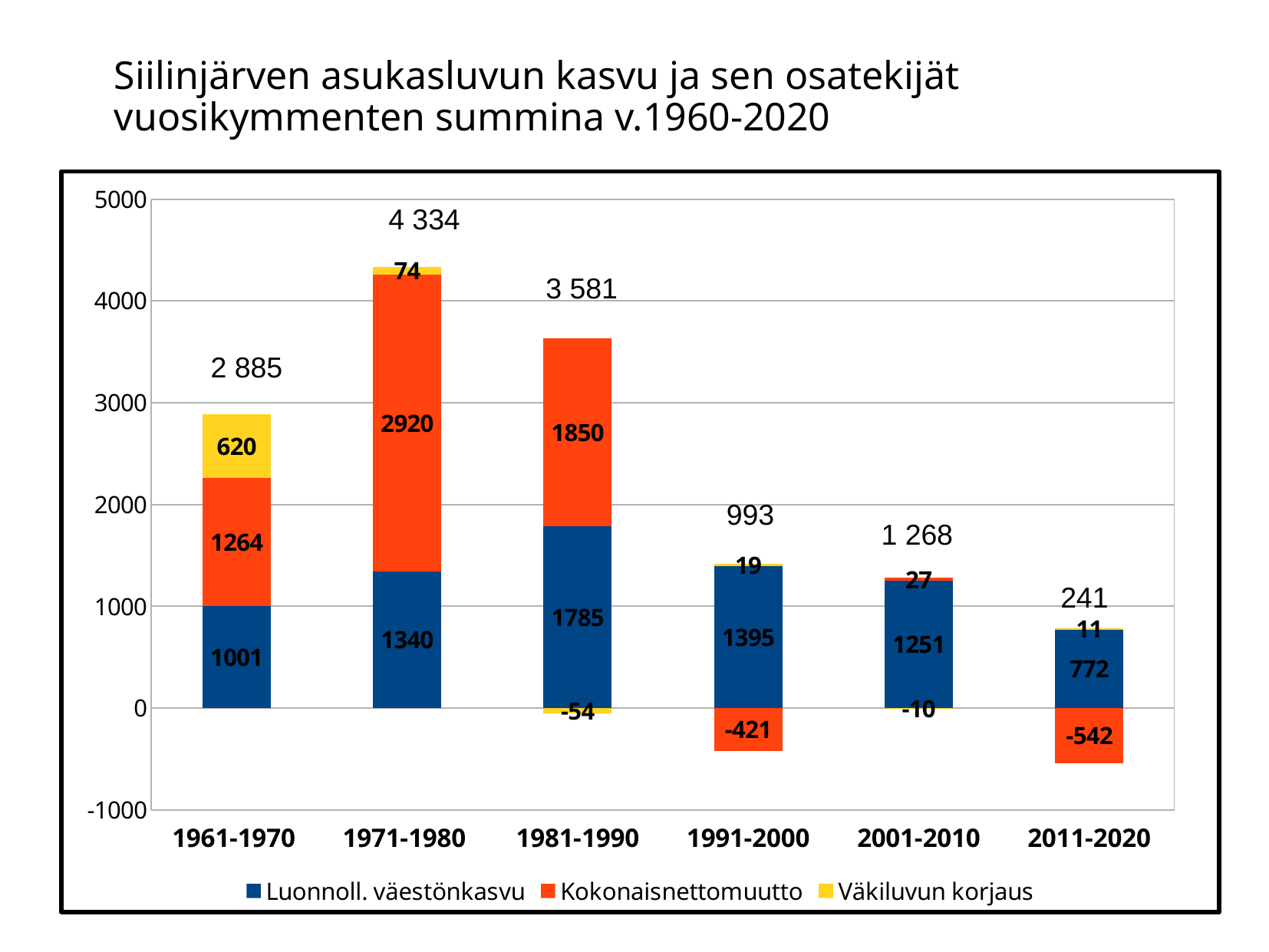
How many series does the legend list? 3 What is the value of Luonnoll. väestönkasvu for 1981-1990? 1785 What is the total shown above the stacked bar for 1971-1980? 4 334 How many decade categories are shown on the x axis? 6 What is the difference between the Kokonaisnettomuutto values for 1971-1980 and 1981-1990? 1070 Which decade has the highest total shown above its bar? 1971-1980 What kind of chart is shown on the slide? Stacked bar chart Which has the larger Luonnoll. väestönkasvu value, 1991-2000 or 2001-2010? 1991-2000 Which series is shown in yellow? Väkiluvun korjaus What is the value of Kokonaisnettomuutto for 2011-2020? -542 What is the value of Väkiluvun korjaus for 1961-1970? 620 Which decade has the lowest total shown above its bar? 2011-2020